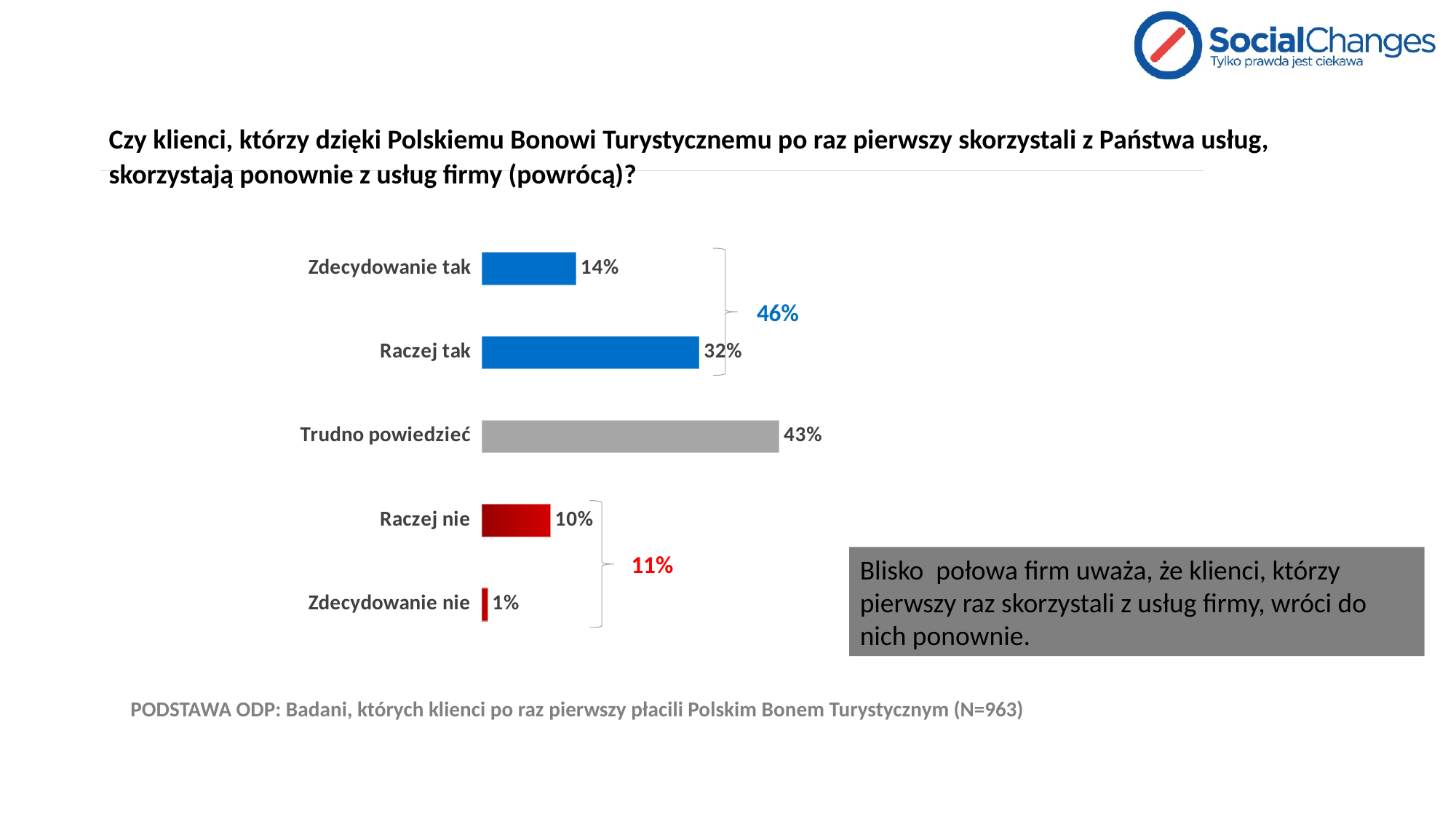
What is the value for "Raczej nie"? 10% What is the value for "Trudno powiedzieć"? 43% How many categories are shown in the chart? 5 What is the difference between the values for "Raczej tak" and "Zdecydowanie tak"? 18% Which category has the highest value? Trudno powiedzieć What is the value for "Zdecydowanie nie"? 1% What colour are the bars for "Raczej nie" and "Zdecydowanie nie"? Red What is the value for "Raczej tak"? 32% Which category has the lowest value? Zdecydowanie nie What kind of chart is shown on the slide? Bar chart Which is larger, the value for "Zdecydowanie tak" or the value for "Raczej nie"? Zdecydowanie tak What combined percentage is shown by the bracket grouping "Zdecydowanie tak" and "Raczej tak"? 46%